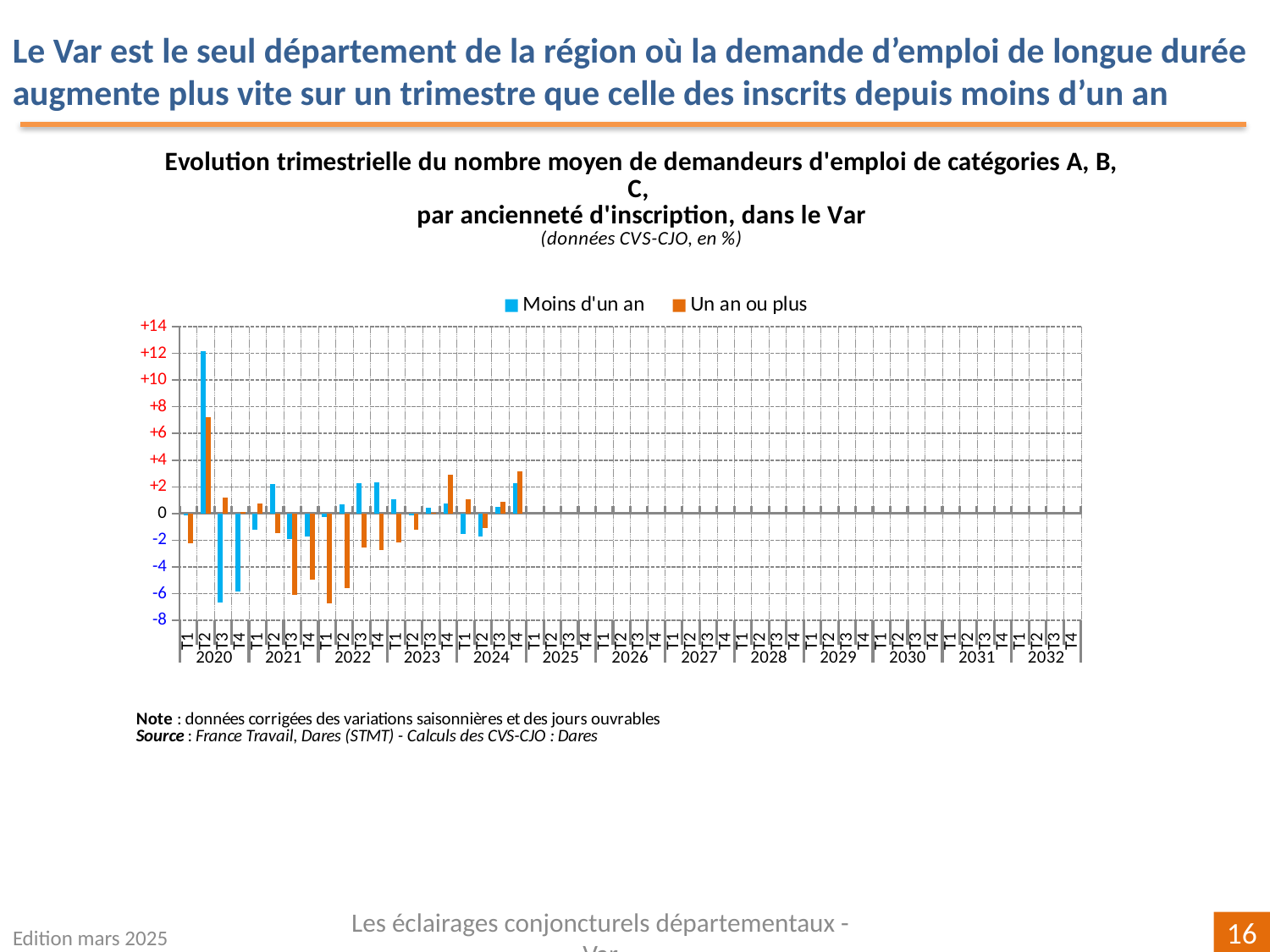
In T2 2020, which series has the larger value, 'Moins d'un an' or 'Un an ou plus'? Moins d'un an In which quarter does the series 'Moins d'un an' reach its highest value? T2 2020 Is the value for 'Un an ou plus' in T4 2024 greater or less than +2? greater How many years are labelled along the x axis? 13 Is the value for 'Un an ou plus' in T1 2022 greater or less than -6? less What kind of chart is shown on the slide? bar chart How many series does the legend list? 2 Is the value for 'Moins d'un an' in T3 2020 greater or less than -4? less What are the two series named in the legend? Moins d'un an; Un an ou plus Which colour represents the series 'Un an ou plus'? orange